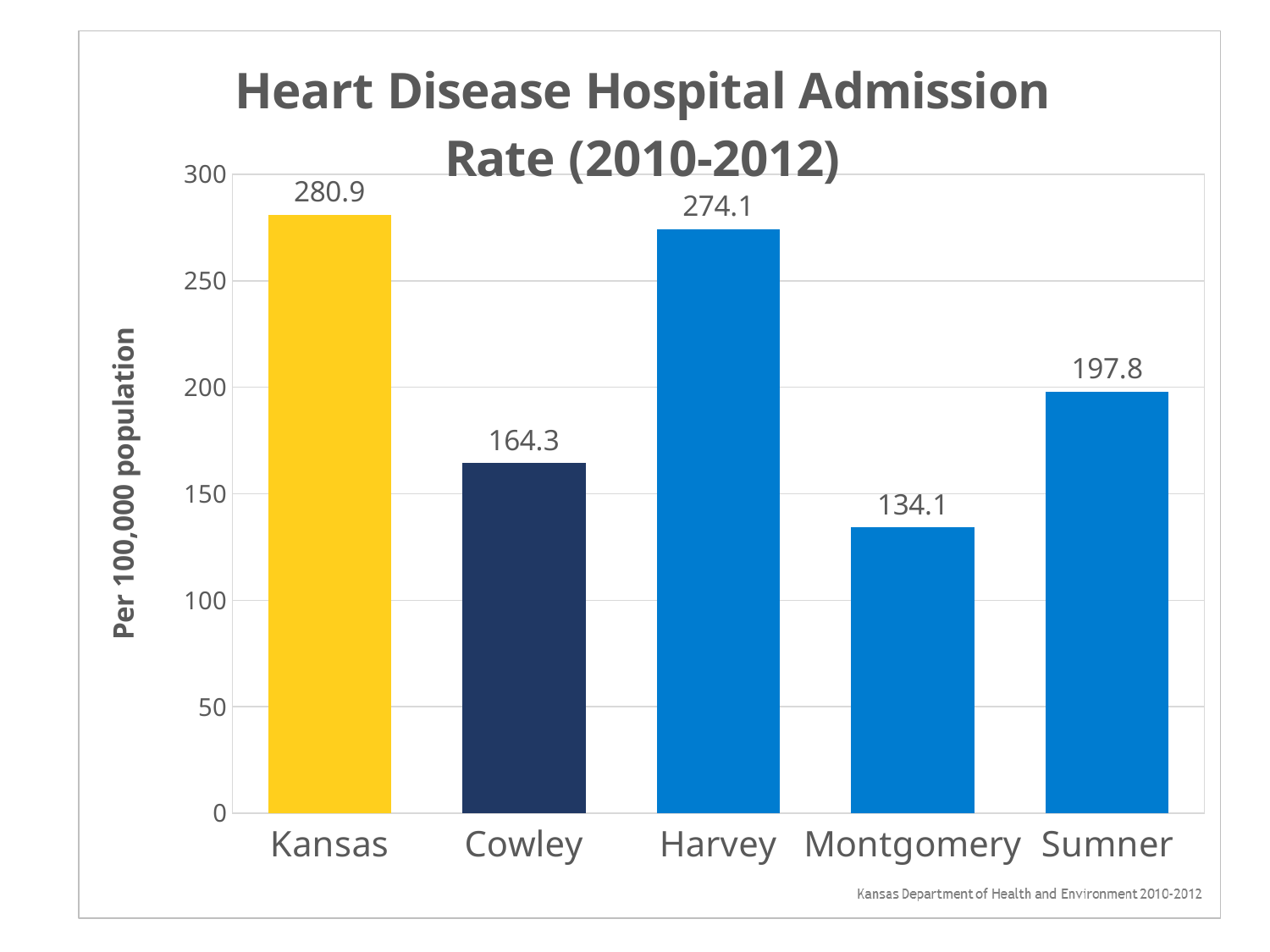
Which category has the highest heart disease hospital admission rate? Kansas Which category has the lowest heart disease hospital admission rate? Montgomery What is the heart disease hospital admission rate for Kansas? 280.9 What is the value shown for Sumner? 197.8 How many categories are shown on the x axis? 5 What kind of chart is shown on the slide? bar chart Which has a higher admission rate, Cowley or Sumner? Sumner What is the difference between the rates for Sumner and Cowley? 33.5 What is the heart disease hospital admission rate for Montgomery? 134.1 Is the value for Harvey greater or less than 250? greater What is the label of the vertical axis? Per 100,000 population What is the difference between the rates for Kansas and Harvey? 6.8